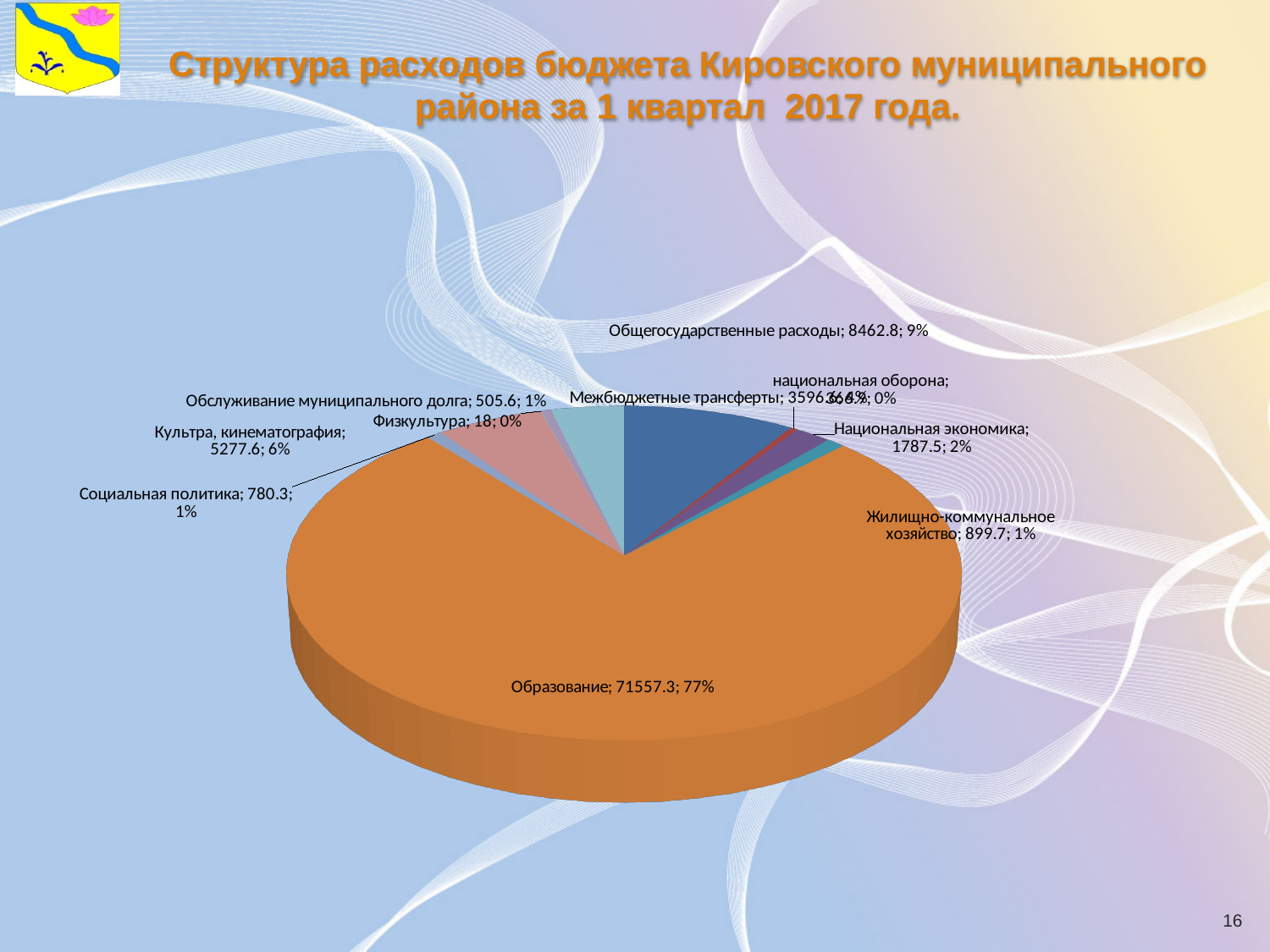
What is the value shown for Общегосударственные расходы? 8462.8 What is the value shown for Национальная экономика? 1787.5 Which category has the smallest value in the pie chart? Физкультура Which is larger: Жилищно-коммунальное хозяйство or Социальная политика? Жилищно-коммунальное хозяйство What share of the pie does Образование represent? 77% What is the difference between the values for Общегосударственные расходы and Культра, кинематография? 3185.2 What is the value shown for Образование? 71557.3 What is the value shown for Обслуживание муниципального долга? 505.6 How many categories are shown in the pie chart? 10 What share of the pie does Культра, кинематография represent? 6% Which category has the largest share of the pie? Образование What kind of chart is shown on the slide? Pie chart